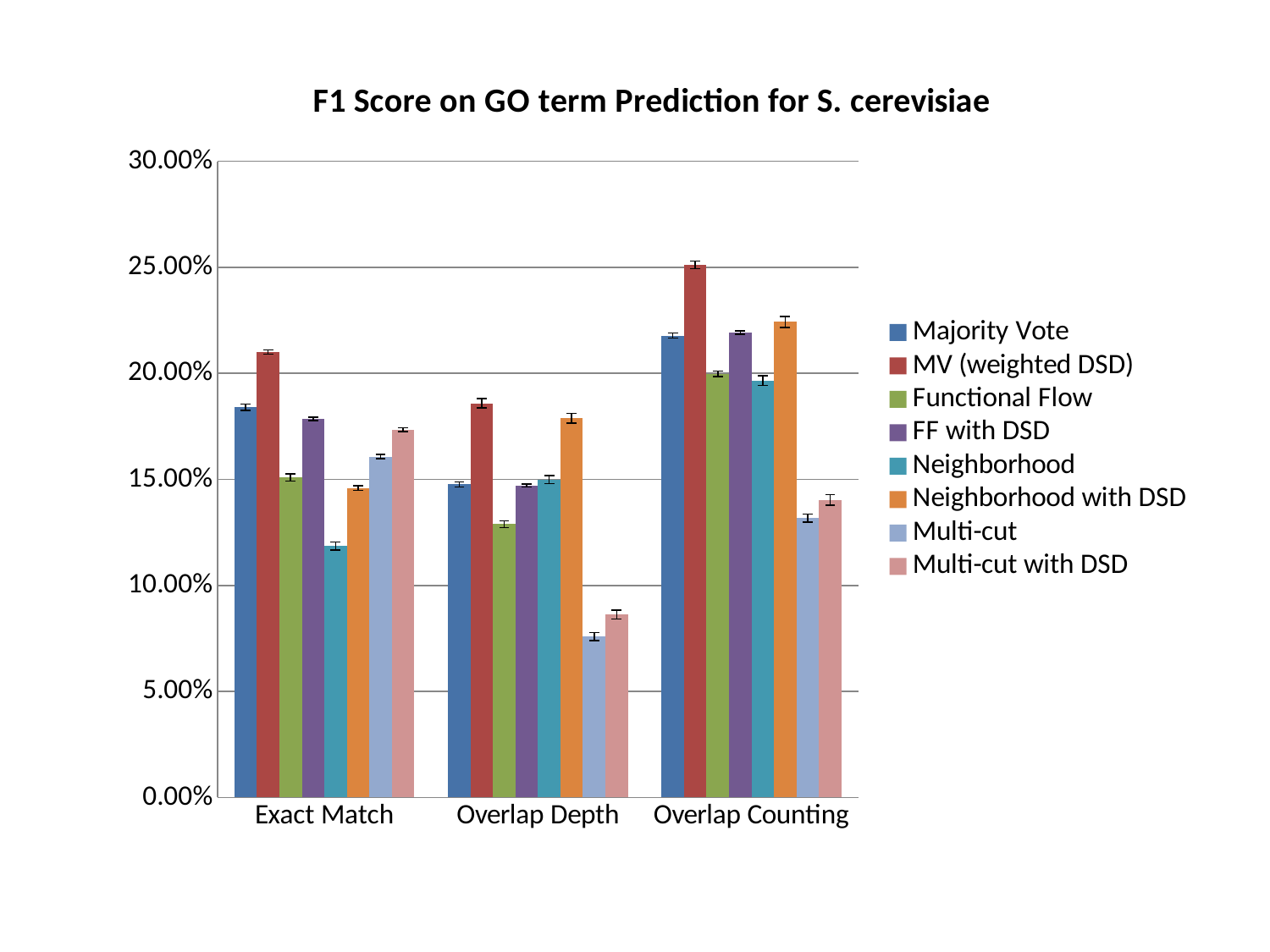
What kind of chart is shown on the slide? bar chart In the Exact Match category, which is larger: Majority Vote or Functional Flow? Majority Vote Is the value for Neighborhood in Exact Match greater or less than 15.00%? less How many series does the legend list? 8 In which category does MV (weighted DSD) reach its highest value? Overlap Counting Is the value for MV (weighted DSD) in Overlap Counting greater or less than 20.00%? greater What is the title of the chart? F1 Score on GO term Prediction for S. cerevisiae Which series has the lowest value in the Overlap Depth category? Multi-cut Is the value for Multi-cut in Overlap Depth greater or less than 10.00%? less Which series has the highest value in the Overlap Counting category? MV (weighted DSD) Which series has the lowest value in the Exact Match category? Neighborhood How many categories are shown on the x axis? 3